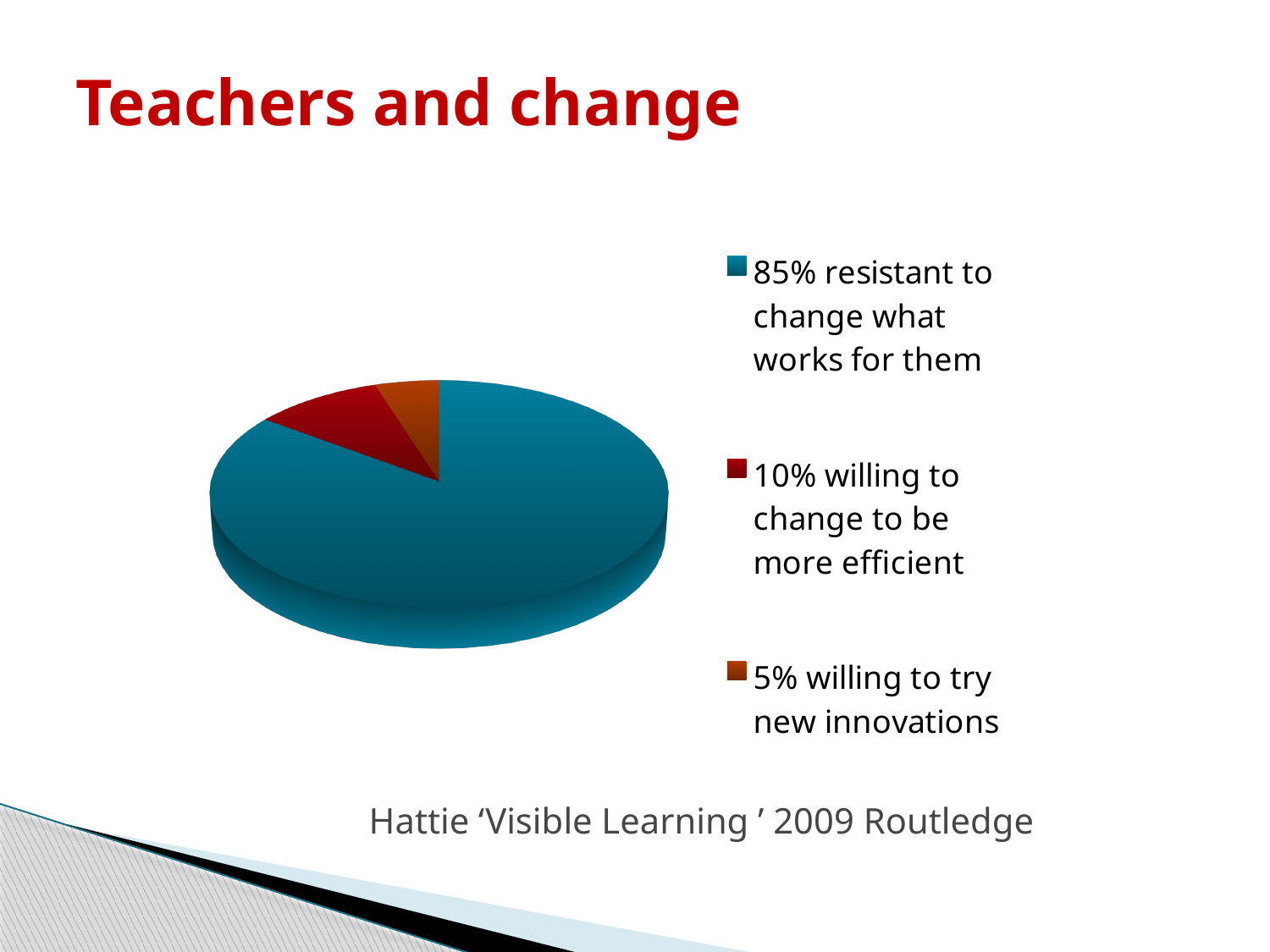
Which category has the smallest slice of the pie? 5% willing to try new innovations What share of the pie is taken by teachers willing to change to be more efficient? 10% What share of the pie is taken by teachers willing to try new innovations? 5% What colour is the slice for teachers resistant to change what works for them? Blue What is the difference in percentage points between the slice for teachers resistant to change and the slice for teachers willing to change to be more efficient? 75 How many slices does the pie chart have? 3 What kind of chart is shown on the slide? Pie chart What share of the pie is taken by teachers resistant to change what works for them? 85% What is the title of the slide containing the pie chart? Teachers and change How many entries does the legend of the pie chart list? 3 Which category has the largest slice of the pie? 85% resistant to change what works for them Which slice is larger: willing to change to be more efficient or willing to try new innovations? 10% willing to change to be more efficient